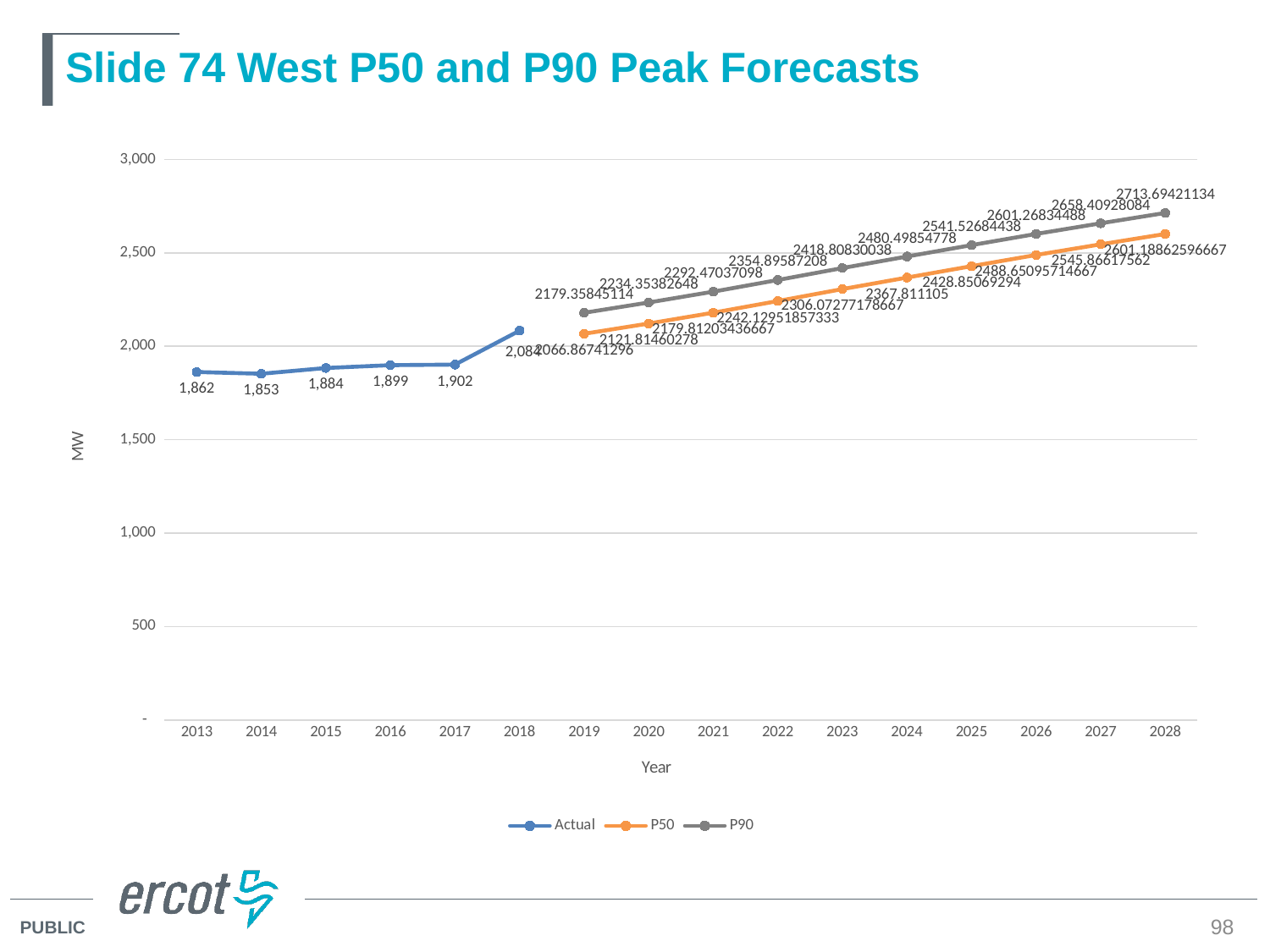
What is the P50 value for 2024? 2367.811105 In which year is the Actual series lowest? 2014 What kind of chart is shown on the slide? line chart What is the difference between the Actual values for 2017 and 2013? 40 What is the label on the vertical axis? MW What is the Actual value for 2013? 1,862 Is the P50 value for 2019 greater or less than 2,000? greater In 2025, which series has the larger value, P50 or P90? P90 What is the Actual value for 2018? 2,084 How many series does the legend list? 3 Does the P90 series rise or fall from 2019 to 2028? rise What is the P90 value for 2028? 2713.69421134